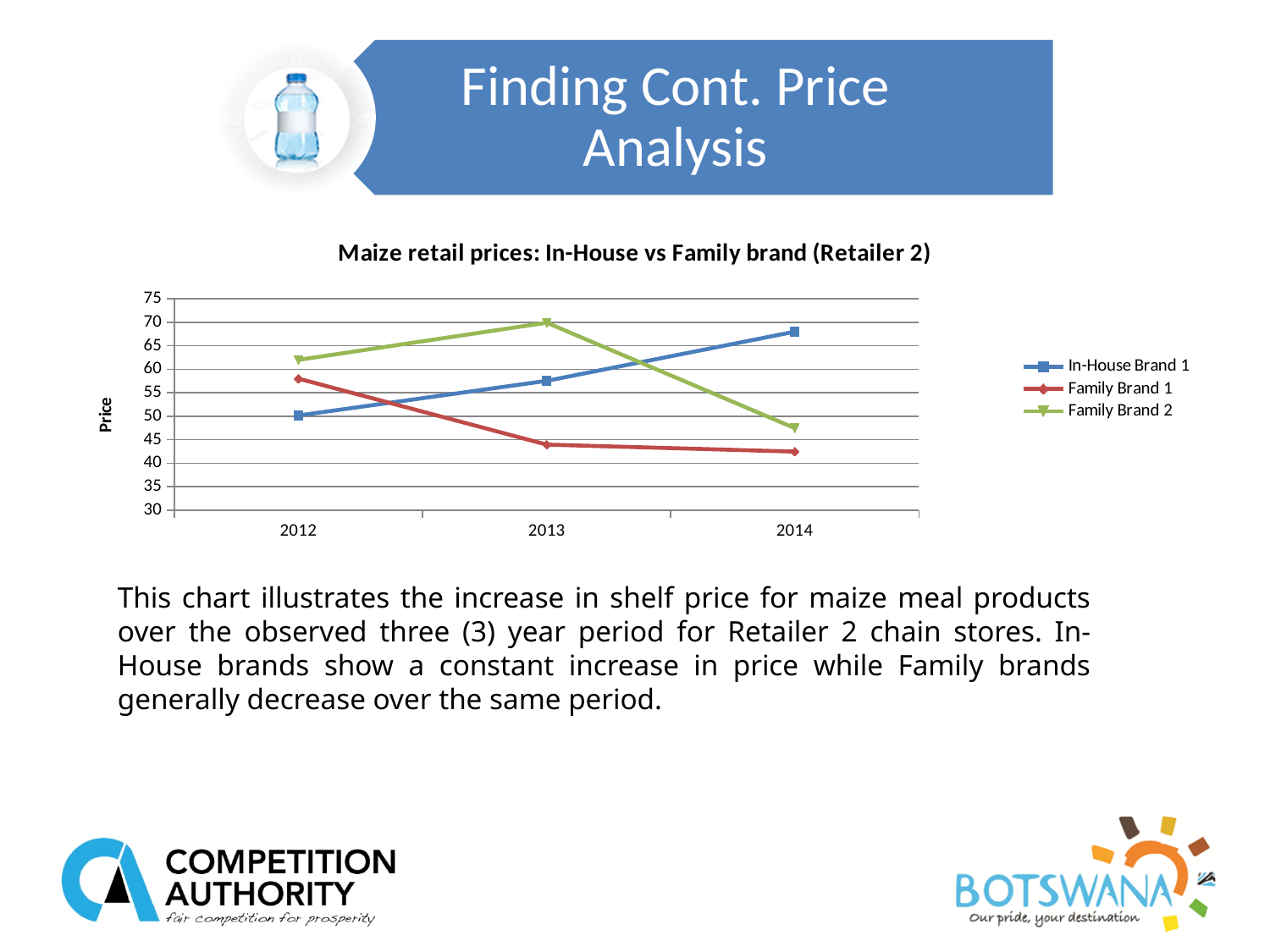
Is the value for Family Brand 2 in 2012 greater or less than 60? greater What is the label of the vertical axis? Price What is the title of the chart? Maize retail prices: In-House vs Family brand (Retailer 2) Is the value for In-House Brand 1 in 2014 greater or less than 65? greater How many years are shown on the x axis? 3 How many series does the legend list? 3 Do the values for Family Brand 1 rise or fall from 2012 to 2014? fall Which is larger in 2014, In-House Brand 1 or Family Brand 2? In-House Brand 1 Is the value for Family Brand 1 in 2013 greater or less than 45? less Do the values for In-House Brand 1 rise or fall from 2012 to 2014? rise Which series has the highest value in 2013? Family Brand 2 What kind of chart is shown on the slide? line chart